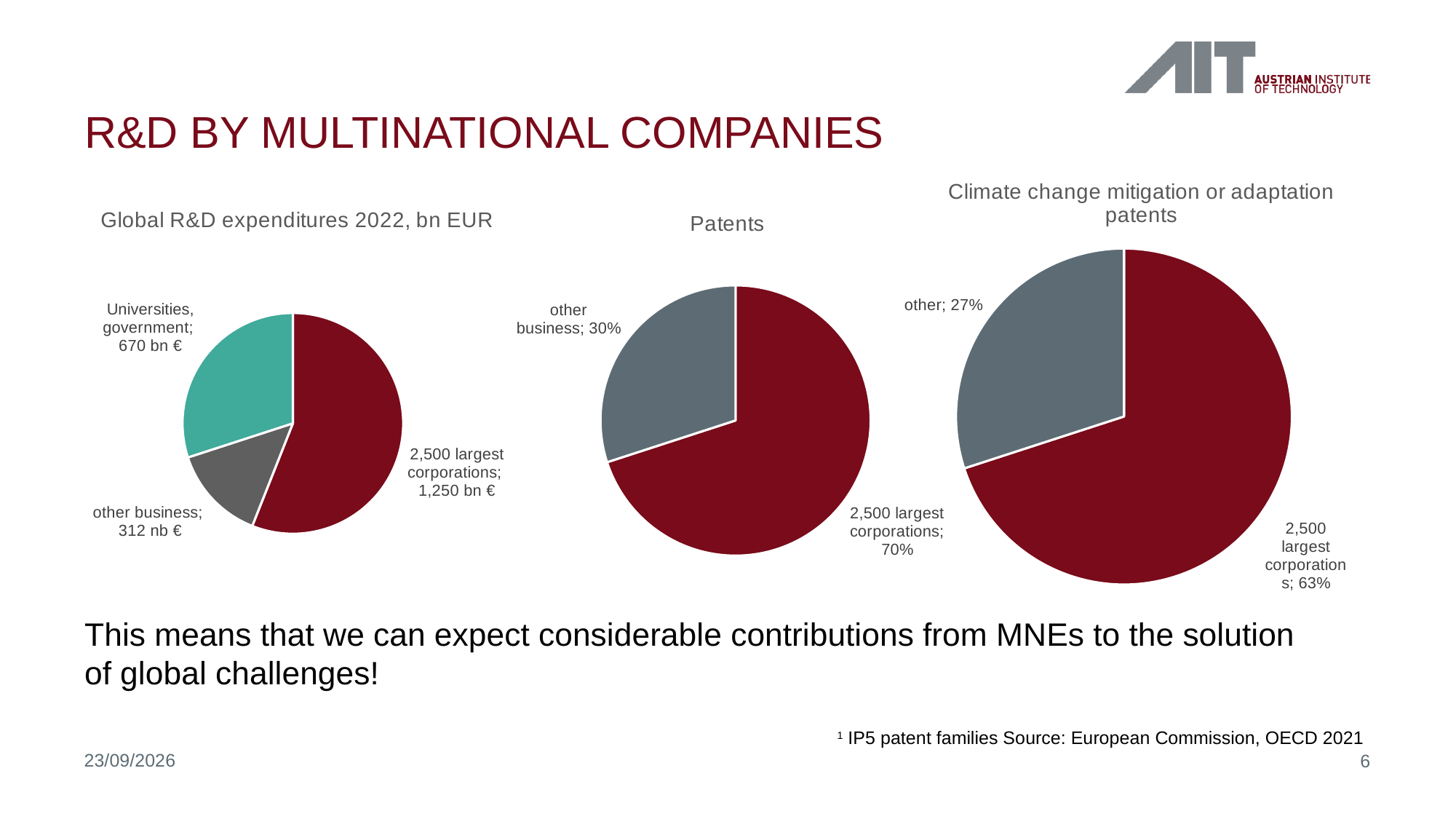
In the 'Global R&D expenditures 2022, bn EUR' chart, how much larger is the value for the 2,500 largest corporations than for Universities, government? 580 bn € How many slices does the 'Global R&D expenditures 2022, bn EUR' pie chart have? 3 In the 'Global R&D expenditures 2022, bn EUR' chart, what is the value for Universities, government? 670 bn € In the 'Patents' chart, what share is attributed to other business? 30% In the 'Global R&D expenditures 2022, bn EUR' chart, which category has the largest value? 2,500 largest corporations In the 'Global R&D expenditures 2022, bn EUR' chart, which category has the smallest value? other business In the 'Global R&D expenditures 2022, bn EUR' chart, what is the value for the 2,500 largest corporations? 1,250 bn € In the 'Climate change mitigation or adaptation patents' chart, what share is attributed to the 2,500 largest corporations? 63% In the 'Patents' chart, what share of patents is attributed to the 2,500 largest corporations? 70% What type of chart is used for the 'Patents' chart? Pie chart Which is larger: the share of the 2,500 largest corporations in the 'Patents' chart or in the 'Climate change mitigation or adaptation patents' chart? Patents